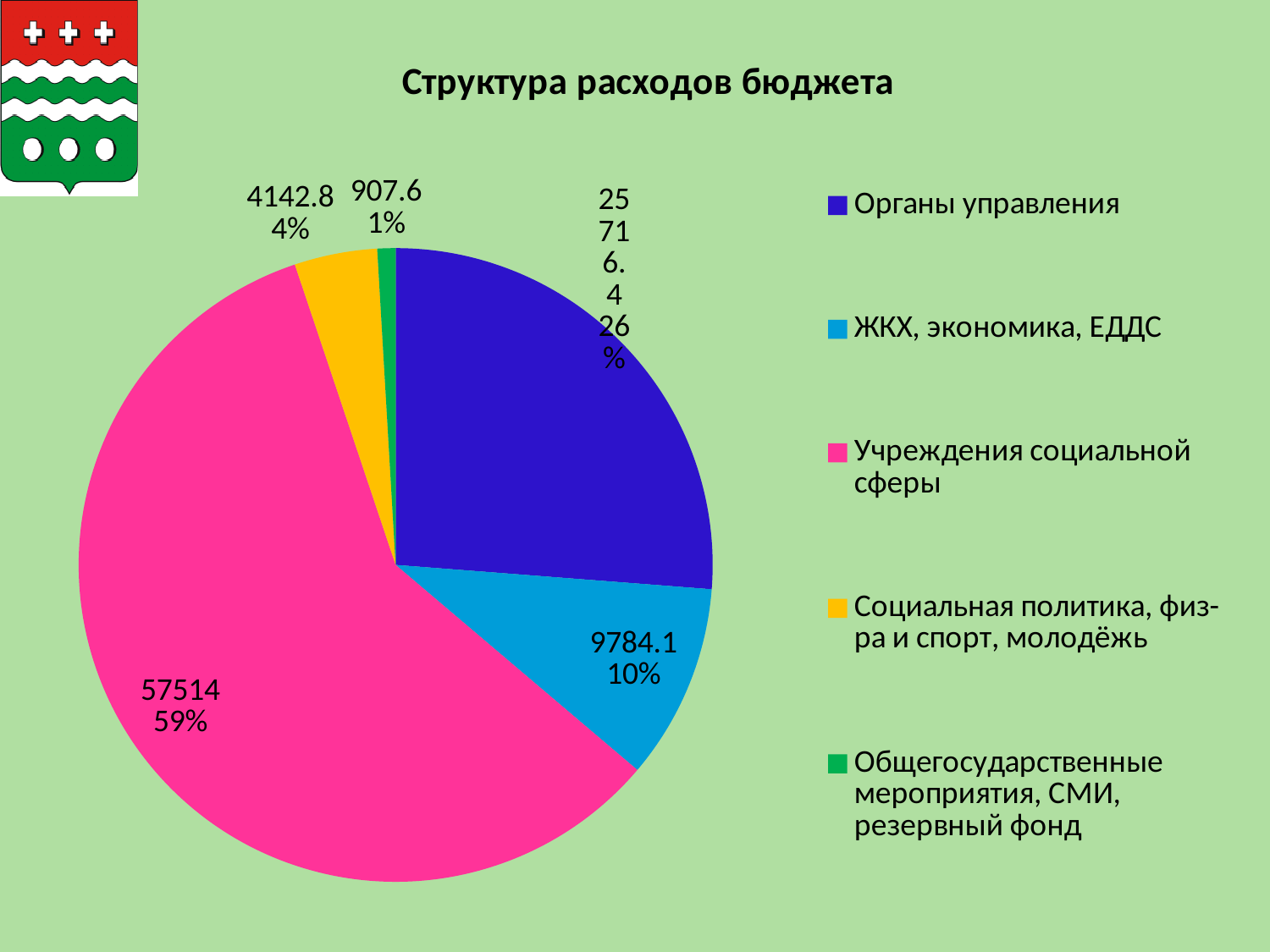
How many slices does the pie chart have? 5 What is the value shown for Социальная политика, физ-ра и спорт, молодёжь? 4142.8 What is the value shown for Учреждения социальной сферы? 57514 What is the title of the chart? Структура расходов бюджета Which category has the largest slice of the pie? Учреждения социальной сферы What share of the pie does ЖКХ, экономика, ЕДДС take? 10% What kind of chart is shown on the slide? pie chart What is the value shown for Общегосударственные мероприятия, СМИ, резервный фонд? 907.6 What is the value shown for ЖКХ, экономика, ЕДДС? 9784.1 What share of the pie does Учреждения социальной сферы take? 59% Which category has the smallest slice of the pie? Общегосударственные мероприятия, СМИ, резервный фонд How many entries does the legend list? 5